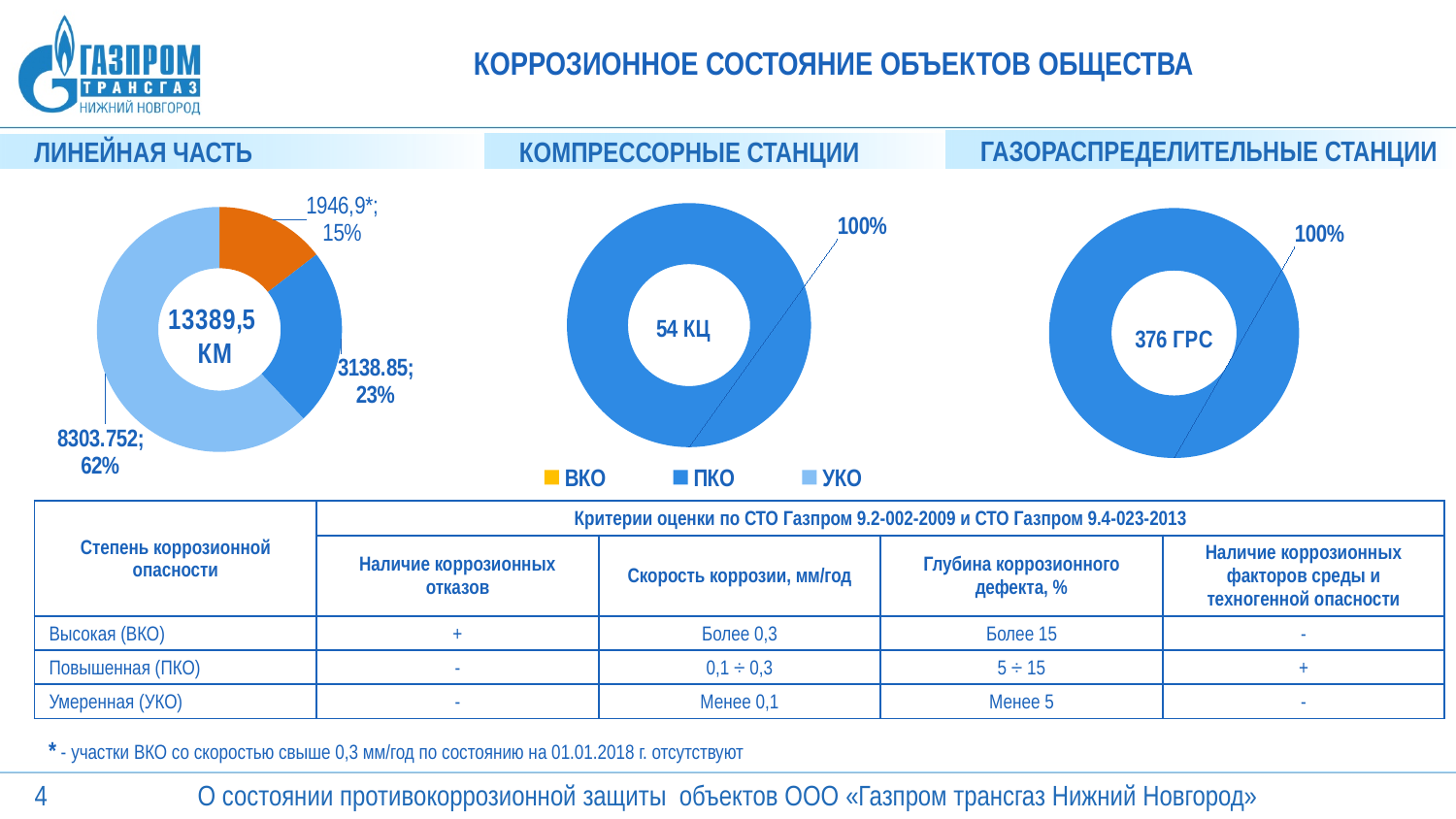
On the ЛИНЕЙНАЯ ЧАСТЬ chart, what value is labelled on the slice with 15%? 1946,9* On the ЛИНЕЙНАЯ ЧАСТЬ chart, how many slices does the doughnut have? 3 On the ЛИНЕЙНАЯ ЧАСТЬ chart, what total is printed in the centre of the doughnut? 13389,5 КМ On the ЛИНЕЙНАЯ ЧАСТЬ chart, what value is labelled on the slice with 62%? 8303.752 On the КОМПРЕССОРНЫЕ СТАНЦИИ chart, what value is printed in the centre of the doughnut? 54 КЦ What kind of chart is used for ЛИНЕЙНАЯ ЧАСТЬ? Doughnut (pie) chart On the ГАЗОРАСПРЕДЕЛИТЕЛЬНЫЕ СТАНЦИИ chart, what percentage is shown for the single slice? 100% On the ЛИНЕЙНАЯ ЧАСТЬ chart, which slice has the smallest share? 15% (1946,9*) How many entries does the legend below the charts list? 3 On the ЛИНЕЙНАЯ ЧАСТЬ chart, what is the difference in percentage points between the 62% slice and the 23% slice? 39 On the ЛИНЕЙНАЯ ЧАСТЬ chart, what percentage share is shown for the largest slice? 62% On the ЛИНЕЙНАЯ ЧАСТЬ chart, what value is labelled on the slice with 23%? 3138.85